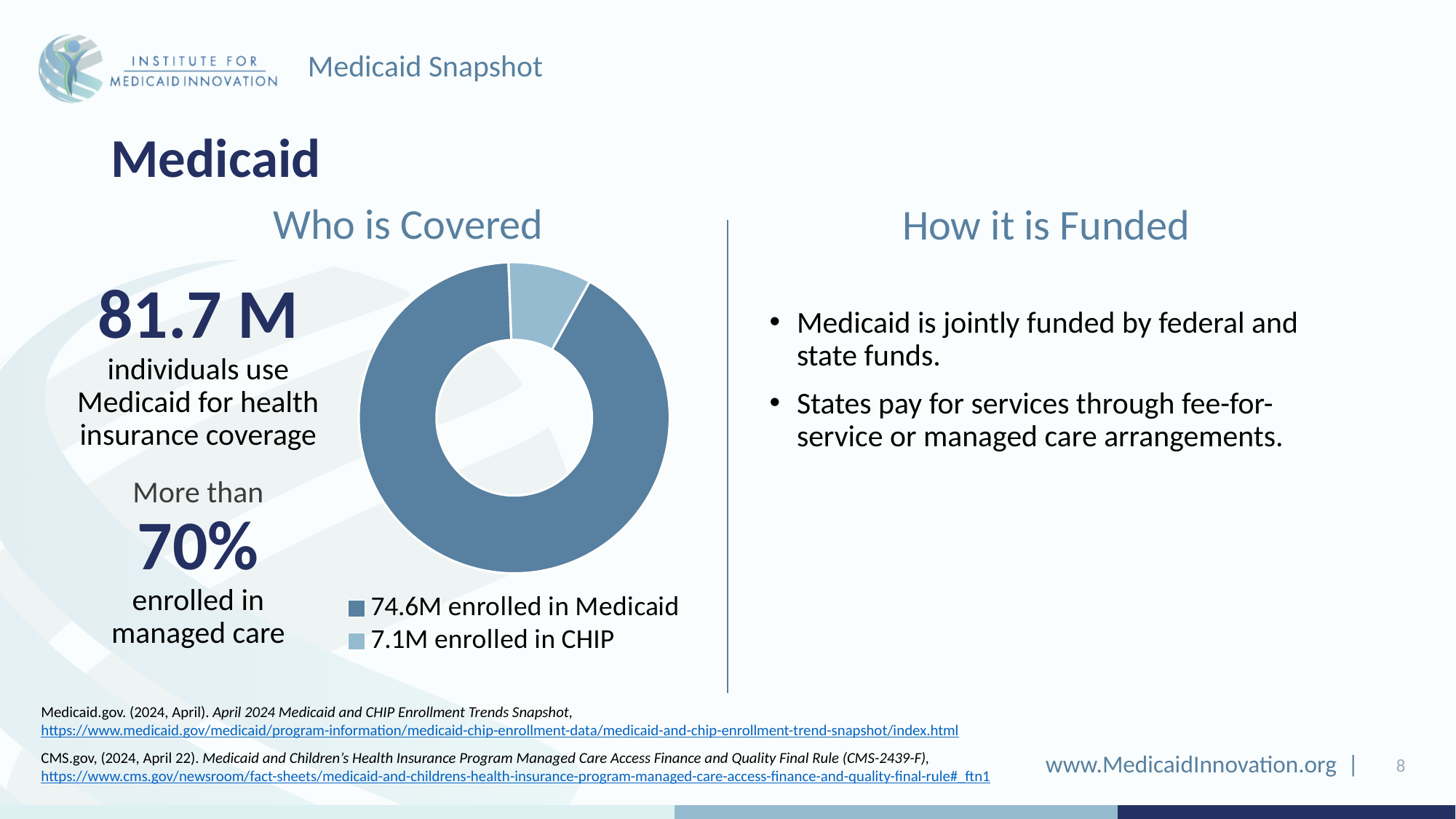
What is the difference between Medicaid enrollment and CHIP enrollment shown in the donut chart? 67.5M According to the donut chart legend, how many people are enrolled in CHIP? 7.1M According to the donut chart legend, how many people are enrolled in Medicaid? 74.6M What is the heading above the donut chart? Who is Covered How many entries does the legend of the donut chart list? 2 Which is larger in the donut chart: enrollment in Medicaid or enrollment in CHIP? Medicaid Which slice of the donut chart is the smallest? 7.1M enrolled in CHIP How many slices does the donut chart have? 2 What kind of chart is shown under "Who is Covered"? donut chart Which slice of the donut chart is the largest? 74.6M enrolled in Medicaid What is the total number of individuals covered, combining the two slices of the donut chart? 81.7 M What colour is the slice representing CHIP enrollment in the donut chart? light blue